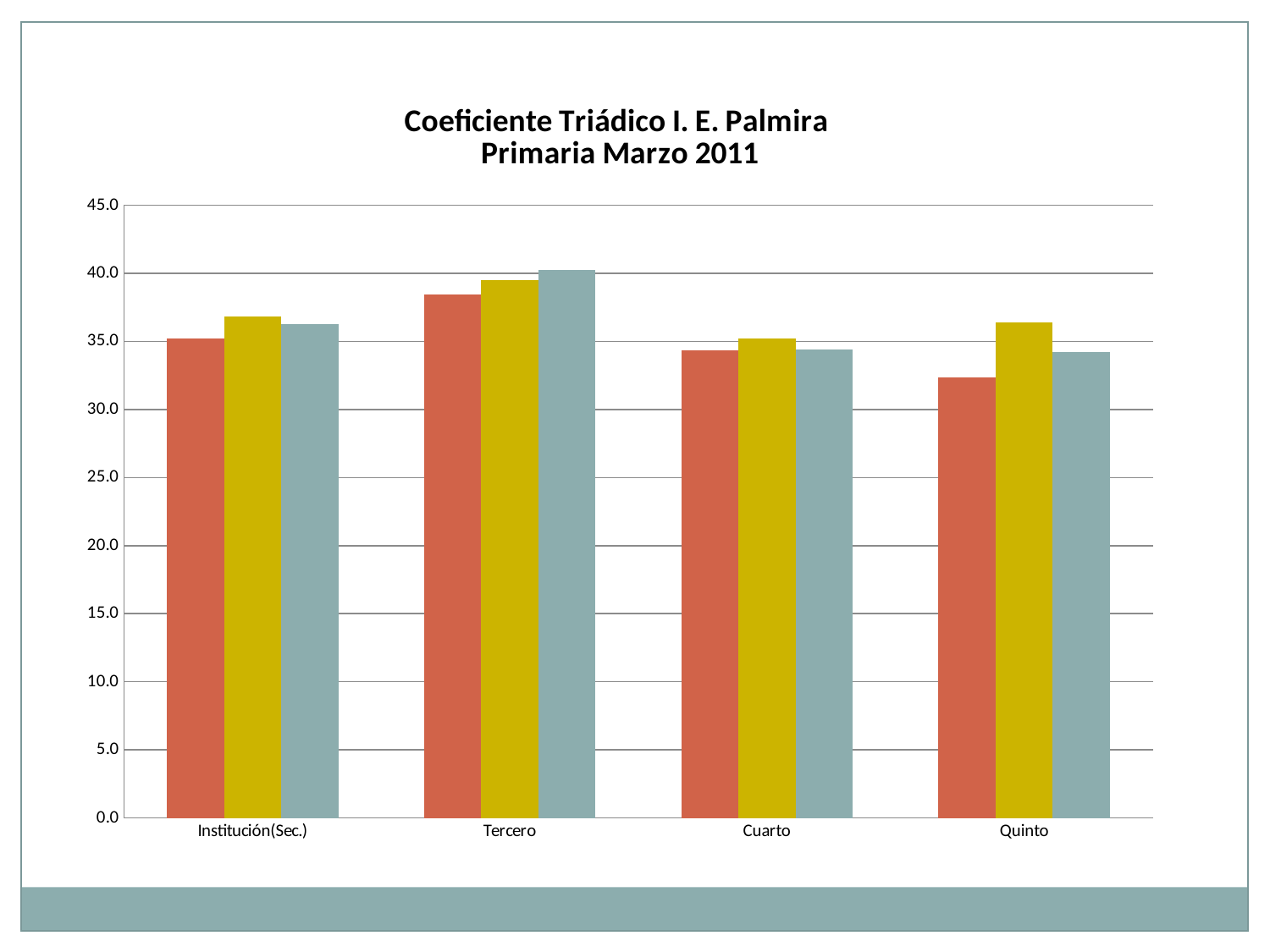
Is the value of the red bar for Quinto greater or less than 35? less Which is larger: the red bar for Tercero or the red bar for Quinto? Tercero Which category has the tallest bars overall? Tercero How many categories are shown on the x axis? 4 Is the value of the red bar for Tercero greater or less than 35? greater How many bars are plotted for each category? 3 Is the value of the yellow bar for Quinto greater or less than 35? greater Within Quinto, which is larger: the yellow bar or the red bar? the yellow bar What is the title of the chart? Coeficiente Triádico I. E. Palmira Primaria Marzo 2011 For the red (first) bars, which category has the lowest value? Quinto For the teal (third) bars, which category has the highest value? Tercero What kind of chart is shown on the slide? bar chart